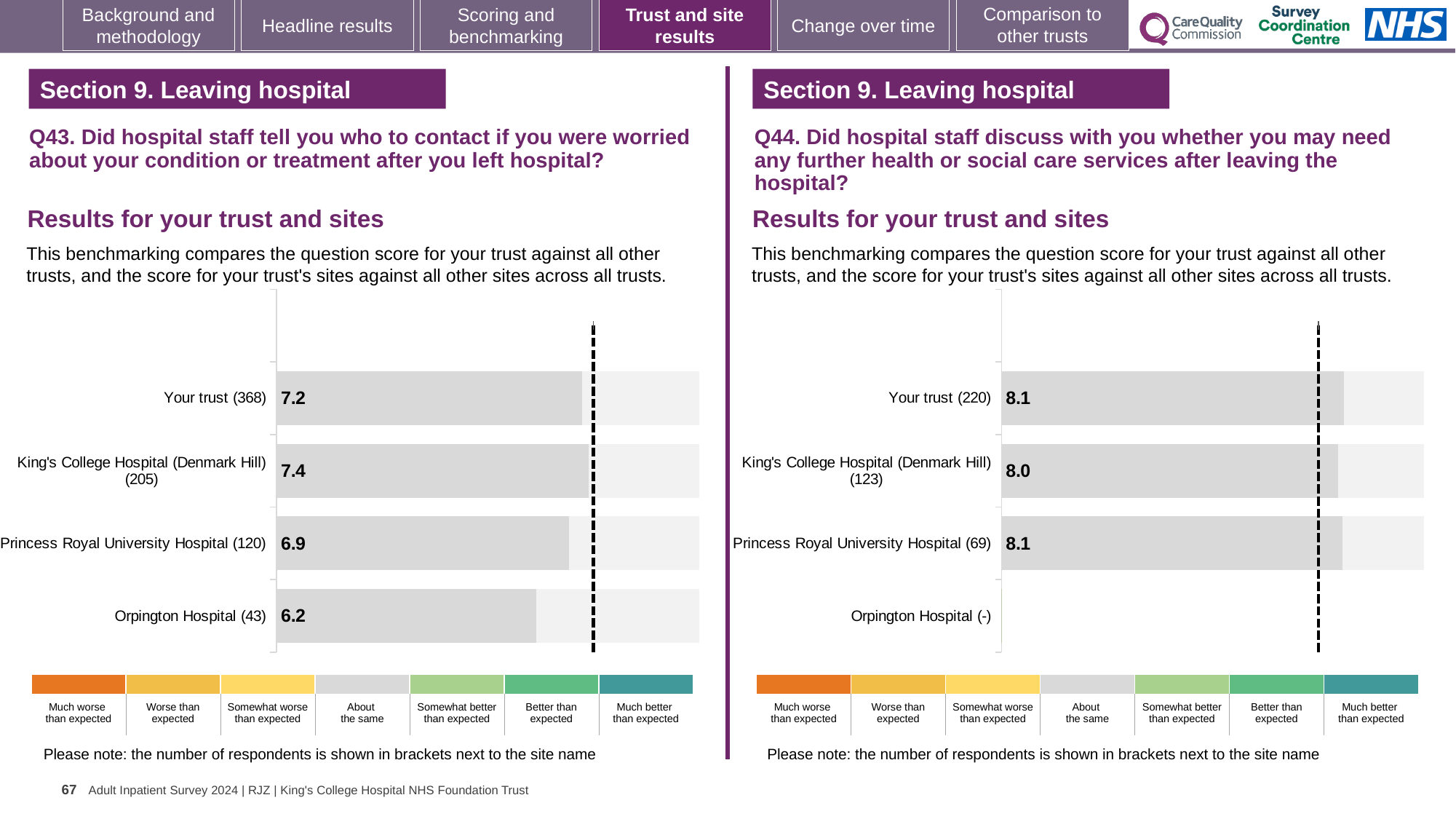
In the Q44 chart on the right, what is the score for Princess Royal University Hospital? 8.1 In the Q43 chart on the left, which site has the highest score? King's College Hospital (Denmark Hill) In the Q43 chart on the left, which site has the lowest score? Orpington Hospital In the Q43 chart on the left, what is the score for Your trust? 7.2 In the Q44 chart on the right, what is the difference between the scores for Your trust and King's College Hospital (Denmark Hill)? 0.1 In the Q43 chart on the left, what is the score for Orpington Hospital? 6.2 In the Q44 chart on the right, how many sites (including Your trust) are listed on the axis? 4 In the Q44 chart on the right, what is the score for King's College Hospital (Denmark Hill)? 8.0 In the Q44 chart on the right, how many respondents are shown in brackets for Your trust? 220 What kind of chart is used in the Q43 chart on the left? Bar chart In the Q43 chart on the left, what is the difference between the scores for King's College Hospital (Denmark Hill) and Orpington Hospital? 1.2 In the Q43 chart on the left, which has the higher score: Princess Royal University Hospital or Your trust? Your trust